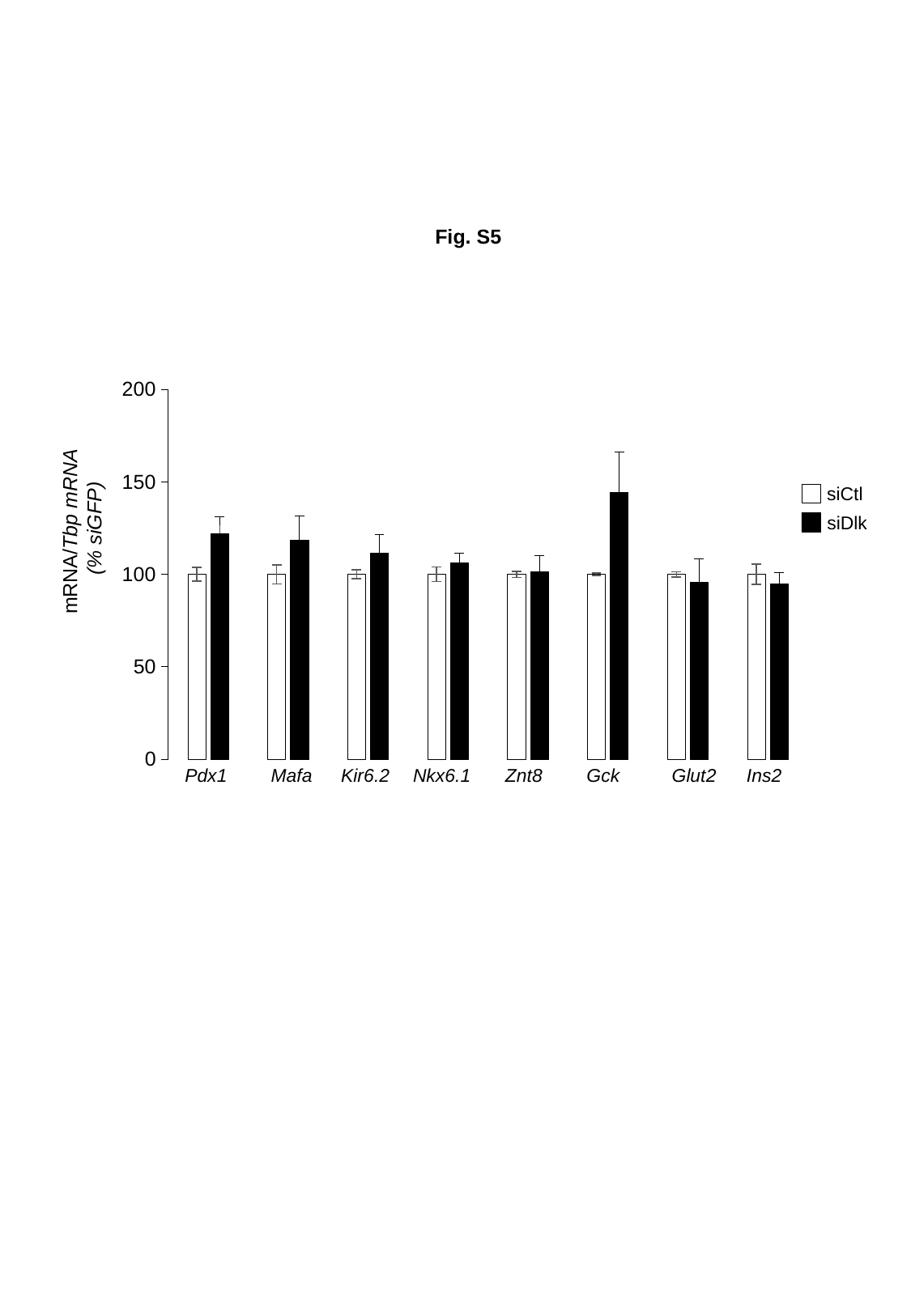
Which is larger, the siDlk value for Pdx1 or the siDlk value for Znt8? Pdx1 What kind of chart is shown on the slide? bar chart What is the title of the figure? Fig. S5 Is the siDlk value for Mafa greater or less than 150? less What are the two series named in the legend? siCtl and siDlk Which is larger, the siDlk value for Gck or the siDlk value for Pdx1? Gck Is the siDlk value for Gck greater or less than 150? less How many gene categories are shown on the x axis? 8 Is the siDlk value for Pdx1 greater or less than 100? greater Which gene has the highest siDlk value? Gck How many series does the legend list? 2